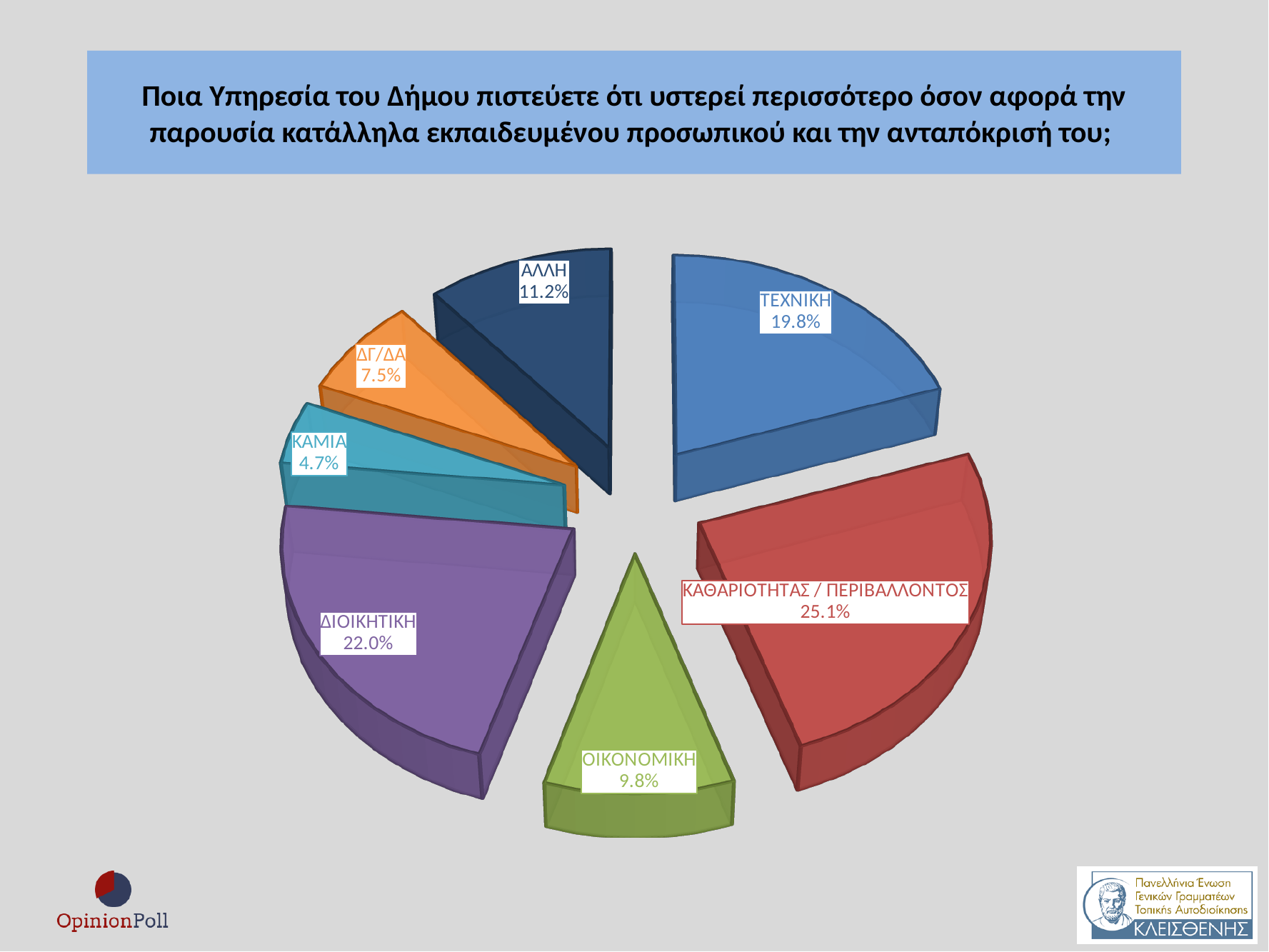
What is the difference in percentage points between ΔΙΟΙΚΗΤΙΚΗ and ΤΕΧΝΙΚΗ? 2.2 How many slices does the pie chart have? 7 Which category has the smallest share of the pie? ΚΑΜΙΑ What percentage is shown for ΚΑΘΑΡΙΟΤΗΤΑΣ / ΠΕΡΙΒΑΛΛΟΝΤΟΣ? 25.1% What colour is the ΔΙΟΙΚΗΤΙΚΗ slice? Purple What percentage is shown for ΟΙΚΟΝΟΜΙΚΗ? 9.8% What is the difference in percentage points between ΚΑΘΑΡΙΟΤΗΤΑΣ / ΠΕΡΙΒΑΛΛΟΝΤΟΣ and ΟΙΚΟΝΟΜΙΚΗ? 15.3 What type of chart is shown on the slide? Pie chart Which category has the largest share of the pie? ΚΑΘΑΡΙΟΤΗΤΑΣ / ΠΕΡΙΒΑΛΛΟΝΤΟΣ Which is larger, ΑΛΛΗ or ΔΓ/ΔΑ? ΑΛΛΗ What percentage is shown for ΚΑΜΙΑ? 4.7% What percentage is shown for ΤΕΧΝΙΚΗ? 19.8%